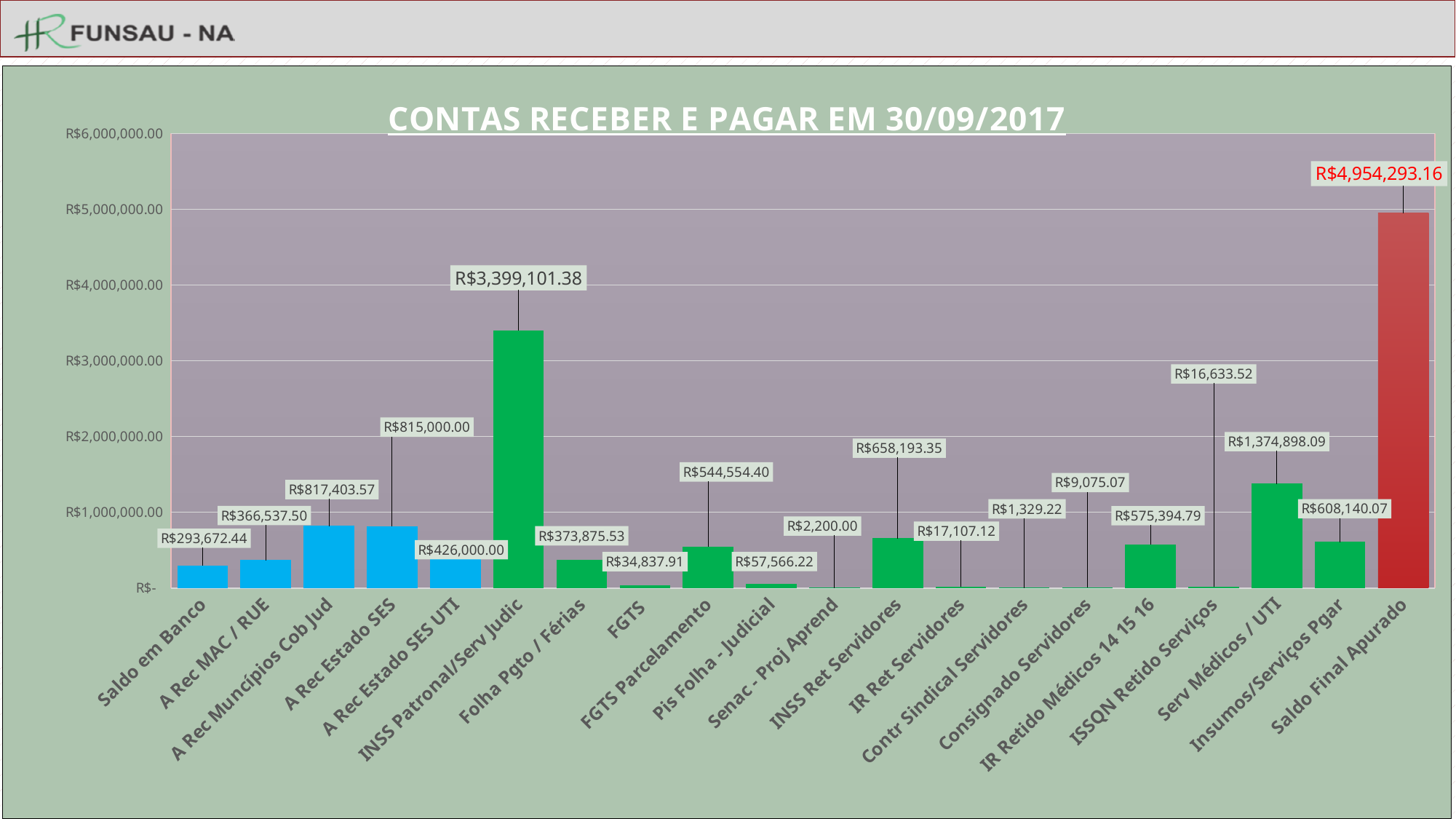
What kind of chart is shown on the slide? bar chart Which category has the lowest value? Contr Sindical Servidores What is the value for Serv Médicos / UTI? R$1,374,898.09 Which category has the highest value? Saldo Final Apurado What is the value for Senac - Proj Aprend? R$2,200.00 What is the value for Saldo em Banco? R$293,672.44 What is the difference between A Rec Muncípios Cob Jud and A Rec Estado SES? R$2,403.57 How many categories are shown on the x axis? 20 What is the difference between Saldo Final Apurado and INSS Patronal/Serv Judic? R$1,555,191.78 What is the value for INSS Patronal/Serv Judic? R$3,399,101.38 Which is larger, Serv Médicos / UTI or INSS Ret Servidores? Serv Médicos / UTI Is the value for INSS Patronal/Serv Judic greater or less than R$3,000,000.00? greater